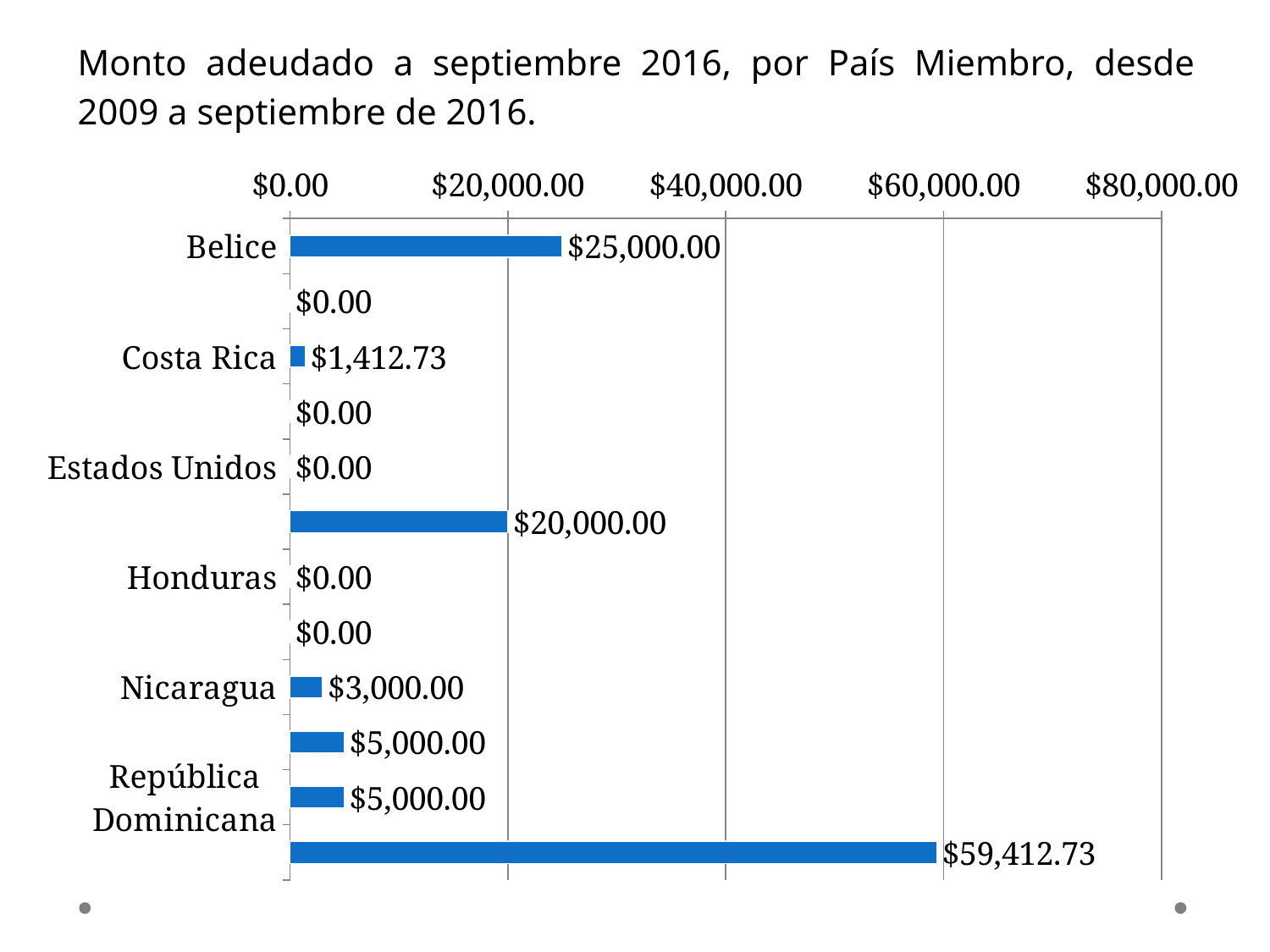
Is the value for Belice greater or less than $20,000.00? greater What is the difference between the values for Belice and República Dominicana? $20,000.00 What is the value for Estados Unidos? $0.00 What is the difference between the values for Nicaragua and Costa Rica? $1,587.27 What is the value for República Dominicana? $5,000.00 What is the value for Belice? $25,000.00 Which is larger, the value for Belice or the value for Nicaragua? Belice What is the value for Costa Rica? $1,412.73 How many bars on the chart have a value of $0.00? 5 What is the value for Nicaragua? $3,000.00 What is the value for Honduras? $0.00 What kind of chart is shown on the slide? bar chart